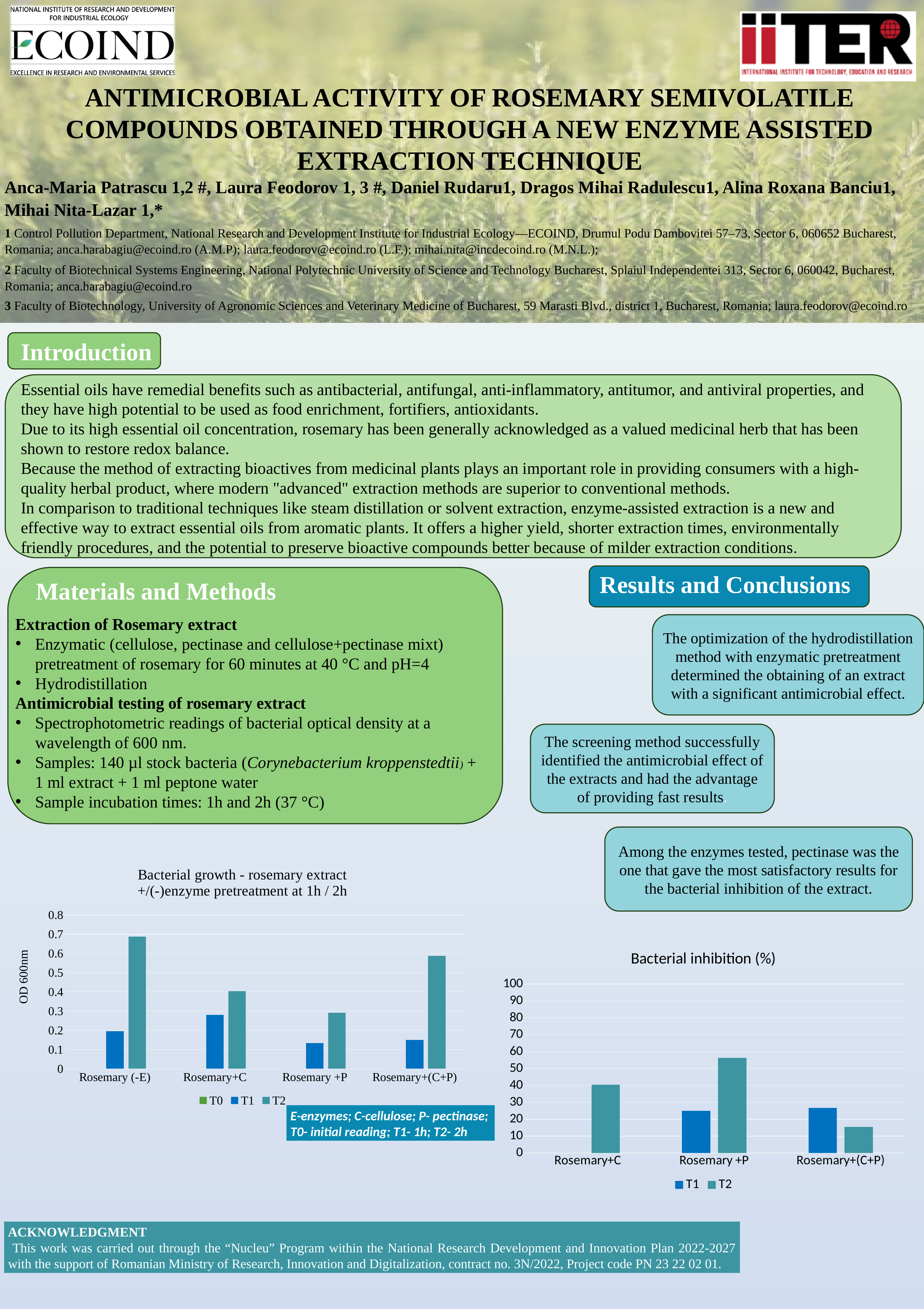
What type of chart is the 'Bacterial growth - rosemary extract +/(-)enzyme pretreatment at 1h / 2h' chart? bar chart In the 'Bacterial inhibition (%)' chart, which is larger for Rosemary+(C+P): the T1 value or the T2 value? T1 In the 'Bacterial growth' chart, is the T2 value for Rosemary (-E) greater or less than 0.6? greater How many categories are shown on the x axis of the 'Bacterial growth' chart? 4 What is the y-axis label of the 'Bacterial growth' chart? OD 600nm In the 'Bacterial growth' chart, is the T1 value for Rosemary +P greater or less than 0.2? less In the 'Bacterial growth' chart, which is larger: the T2 value for Rosemary+C or the T2 value for Rosemary+(C+P)? Rosemary+(C+P) How many series does the legend of the 'Bacterial inhibition (%)' chart list? 2 In the 'Bacterial inhibition (%)' chart, is the T2 value for Rosemary +P greater or less than 50? greater In the 'Bacterial growth' chart, which category has the highest T2 value? Rosemary (-E) In the 'Bacterial inhibition (%)' chart, which category has the highest T2 value? Rosemary +P How many series does the legend of the 'Bacterial growth' chart list? 3